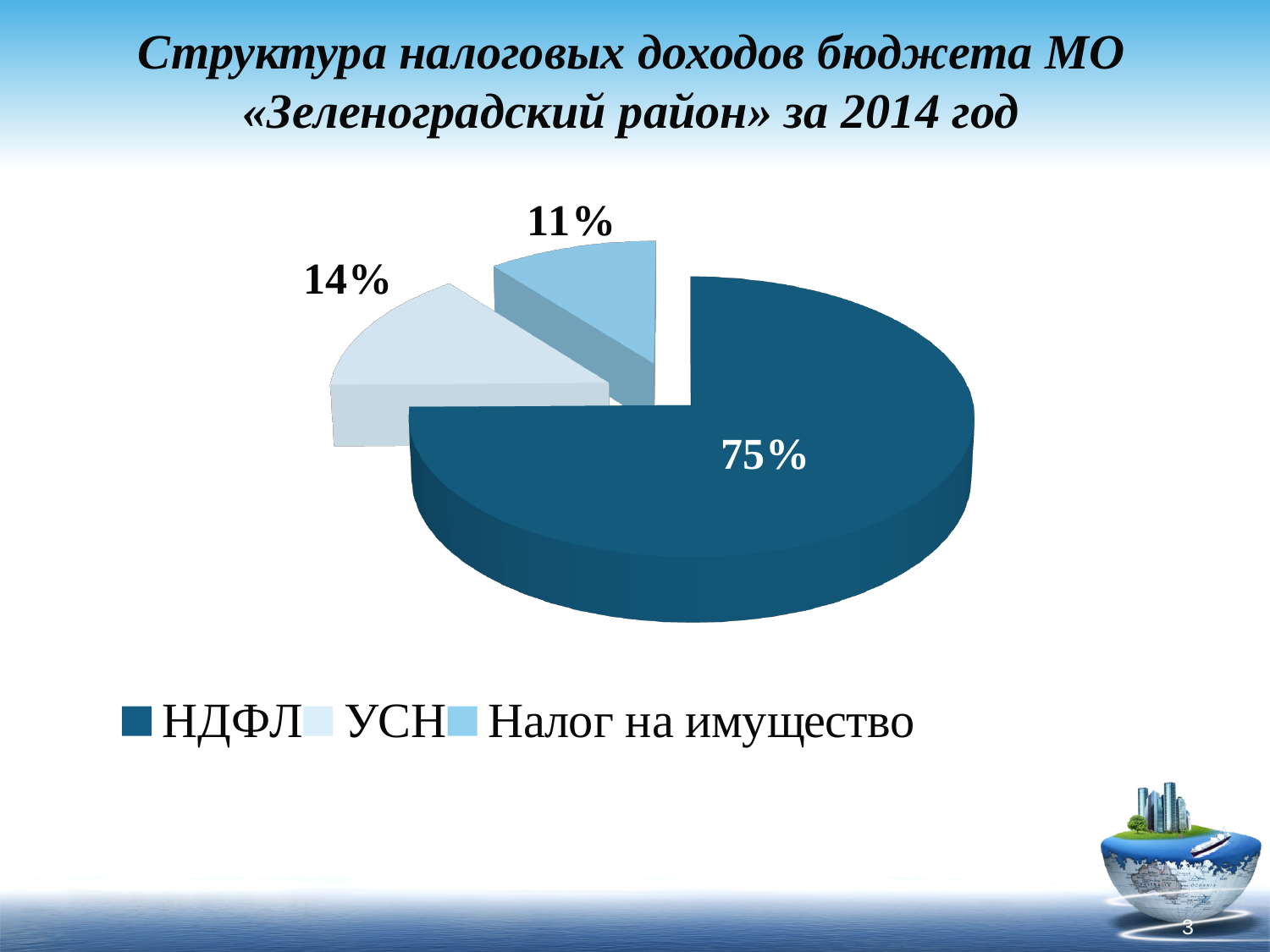
How many categories are shown in the pie chart? 3 What is the difference in percentage points between the УСН slice and the Налог на имущество slice? 3 Which category has the largest slice of the pie? НДФЛ Which category has the smallest slice of the pie? Налог на имущество What kind of chart is shown on the slide? Pie chart What is the title of the chart on the slide? Структура налоговых доходов бюджета МО «Зеленоградский район» за 2014 год What share of the pie does Налог на имущество account for? 11% Which is larger, the share for УСН or the share for Налог на имущество? УСН What share of the pie does УСН account for? 14% Which category is shown in the darkest blue colour in the legend? НДФЛ What is the difference in percentage points between the НДФЛ slice and the УСН slice? 61 What share of the pie does НДФЛ account for? 75%